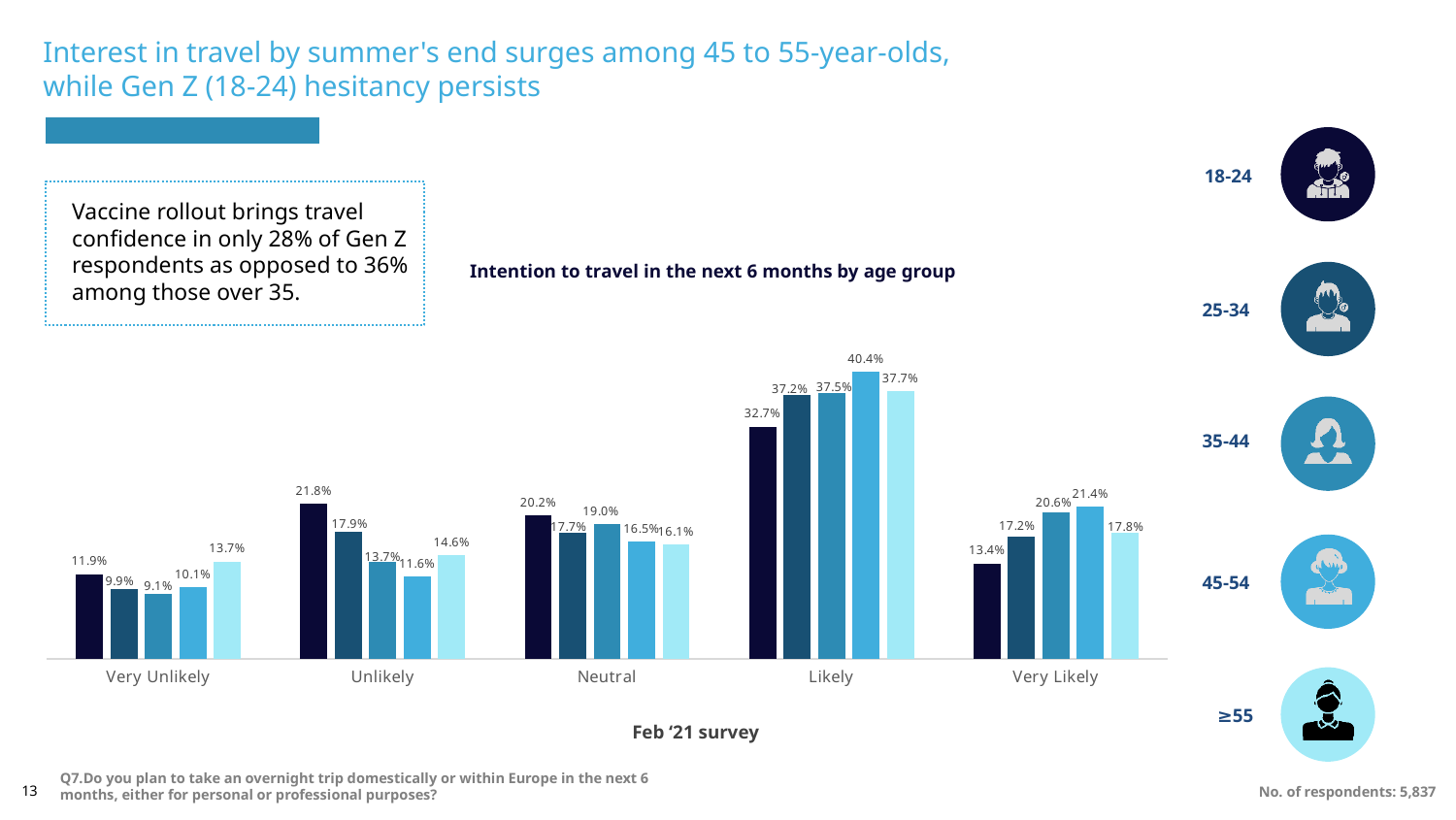
What is the difference between the 45-54 and 18-24 values in the Likely category? 7.7 percentage points How many age groups does the legend list? 5 Which age group has the lowest value in the Very Unlikely category? 35-44 What is the value for the ≥55 age group in the Very Unlikely category? 13.7% Which age group has the highest value in the Very Likely category? 45-54 How many response categories are shown on the x axis? 5 What is the value for the 45-54 age group in the Likely category? 40.4% In the Neutral category, which is larger: the value for 18-24 or the value for 35-44? 18-24 What kind of chart is shown on the slide? Bar chart What is the value for the 25-34 age group in the Very Likely category? 17.2% What is the value for the 18-24 age group in the Unlikely category? 21.8% What is the title of the chart? Intention to travel in the next 6 months by age group